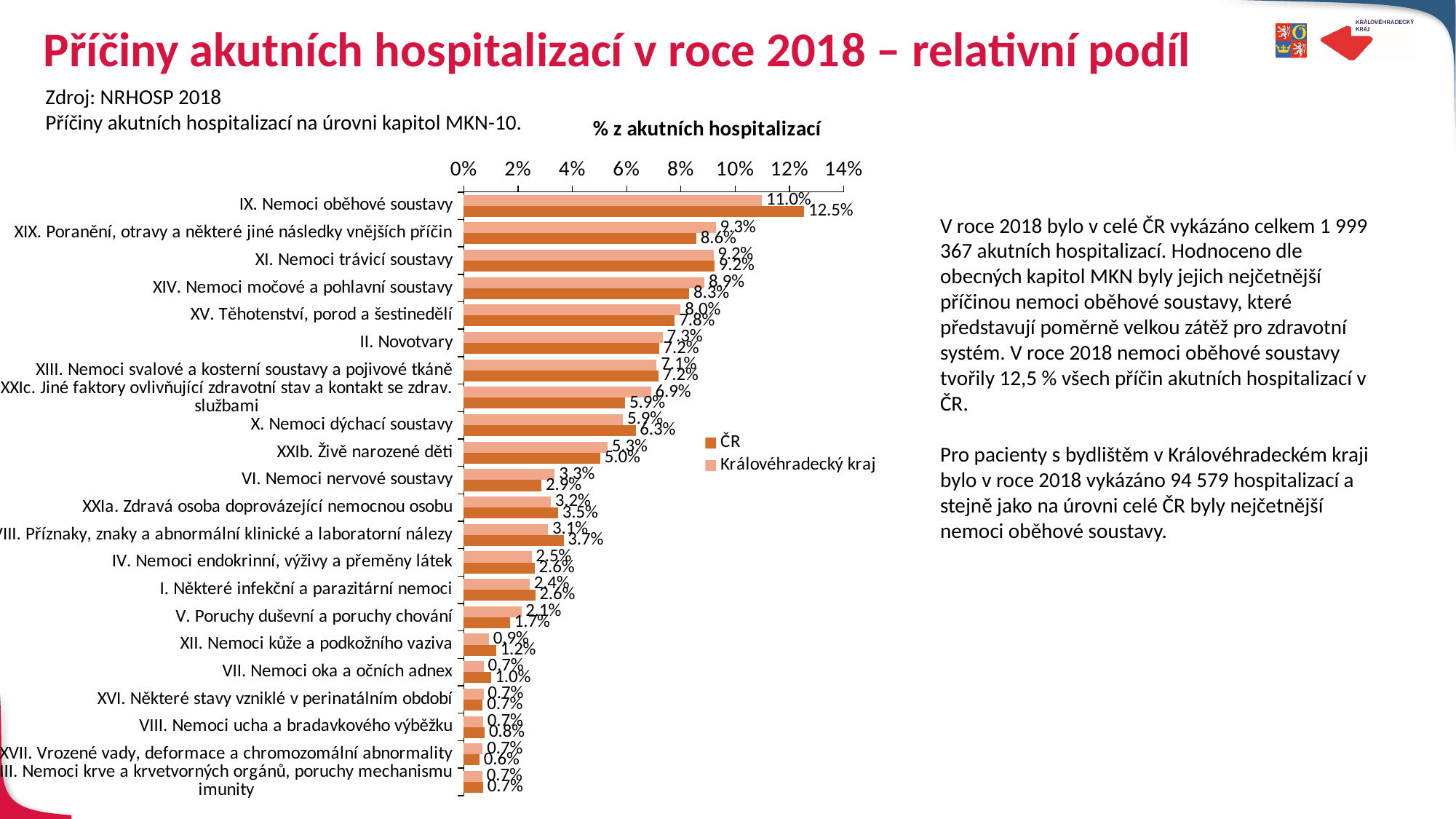
Which category has the highest ČR value? IX. Nemoci oběhové soustavy What is the difference between the ČR and Královéhradecký kraj values for IX. Nemoci oběhové soustavy? 1.5% What is the ČR value for IX. Nemoci oběhové soustavy? 12.5% What is the title of the chart? % z akutních hospitalizací For XVIII. Příznaky, znaky a abnormální klinické a laboratorní nálezy, which is larger: the ČR value or the Královéhradecký kraj value? ČR What kind of chart is shown on the slide? Bar chart How many categories are shown on the chart? 22 What is the Královéhradecký kraj value for IX. Nemoci oběhové soustavy? 11.0% How many series does the legend list? 2 For XXIc. Jiné faktory ovlivňující zdravotní stav a kontakt se zdrav. službami, which is larger: the ČR value or the Královéhradecký kraj value? Královéhradecký kraj What is the ČR value for X. Nemoci dýchací soustavy? 6.3% What is the Královéhradecký kraj value for XIX. Poranění, otravy a některé jiné následky vnějších příčin? 9.3%